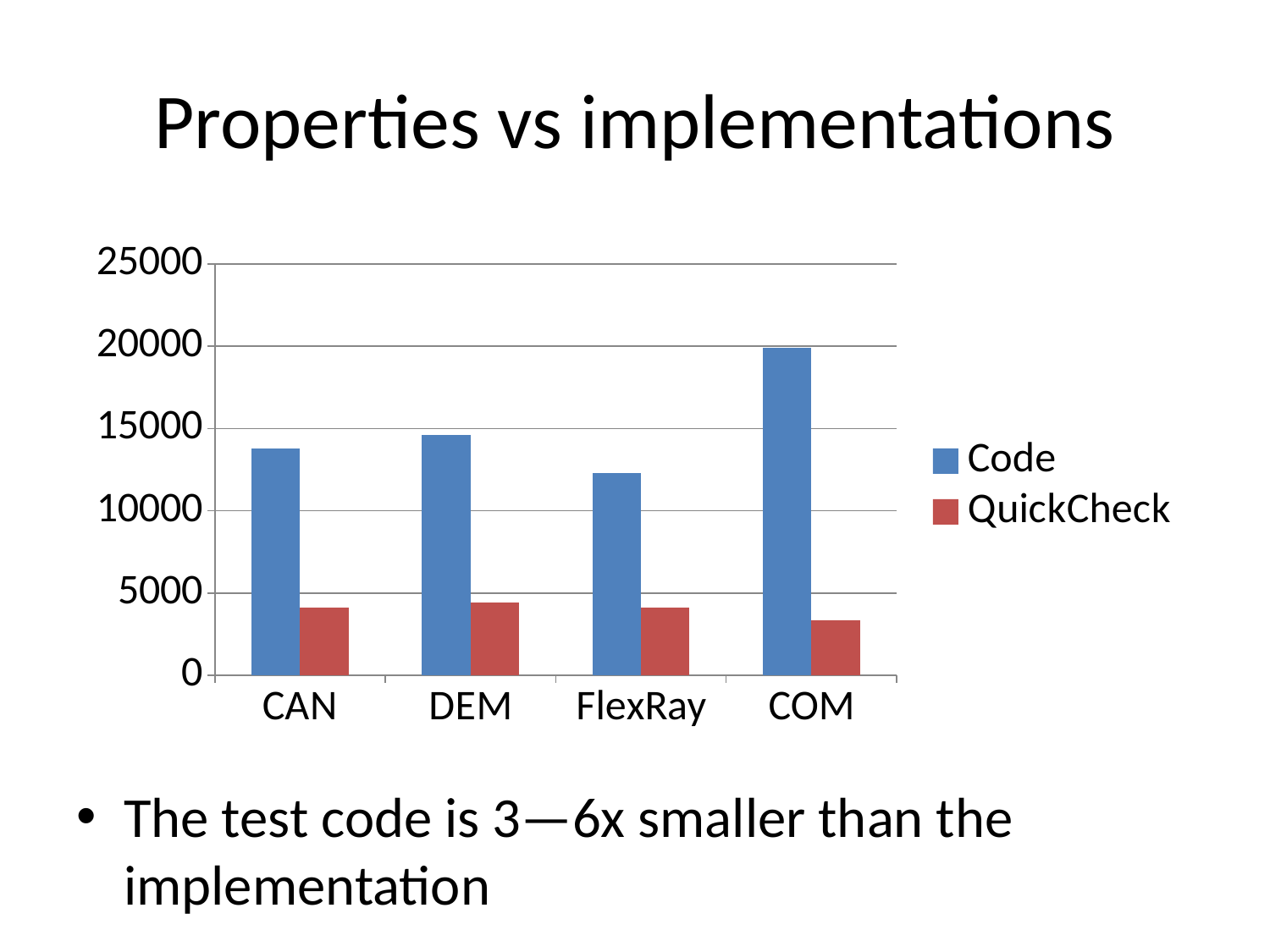
What is the title of the slide containing the chart? Properties vs implementations Which category has the highest Code value? COM What kind of chart is shown on the slide? bar chart For COM, which is larger: Code or QuickCheck? Code Is the Code value for FlexRay greater or less than 10000? greater How many series does the chart's legend list? 2 Which category has the lowest QuickCheck value? COM Is the QuickCheck value for COM greater or less than 5000? less Which category has the lowest Code value? FlexRay What are the two series named in the chart's legend? Code and QuickCheck How many categories are shown on the x axis of the chart? 4 Is the Code value for COM greater or less than 15000? greater